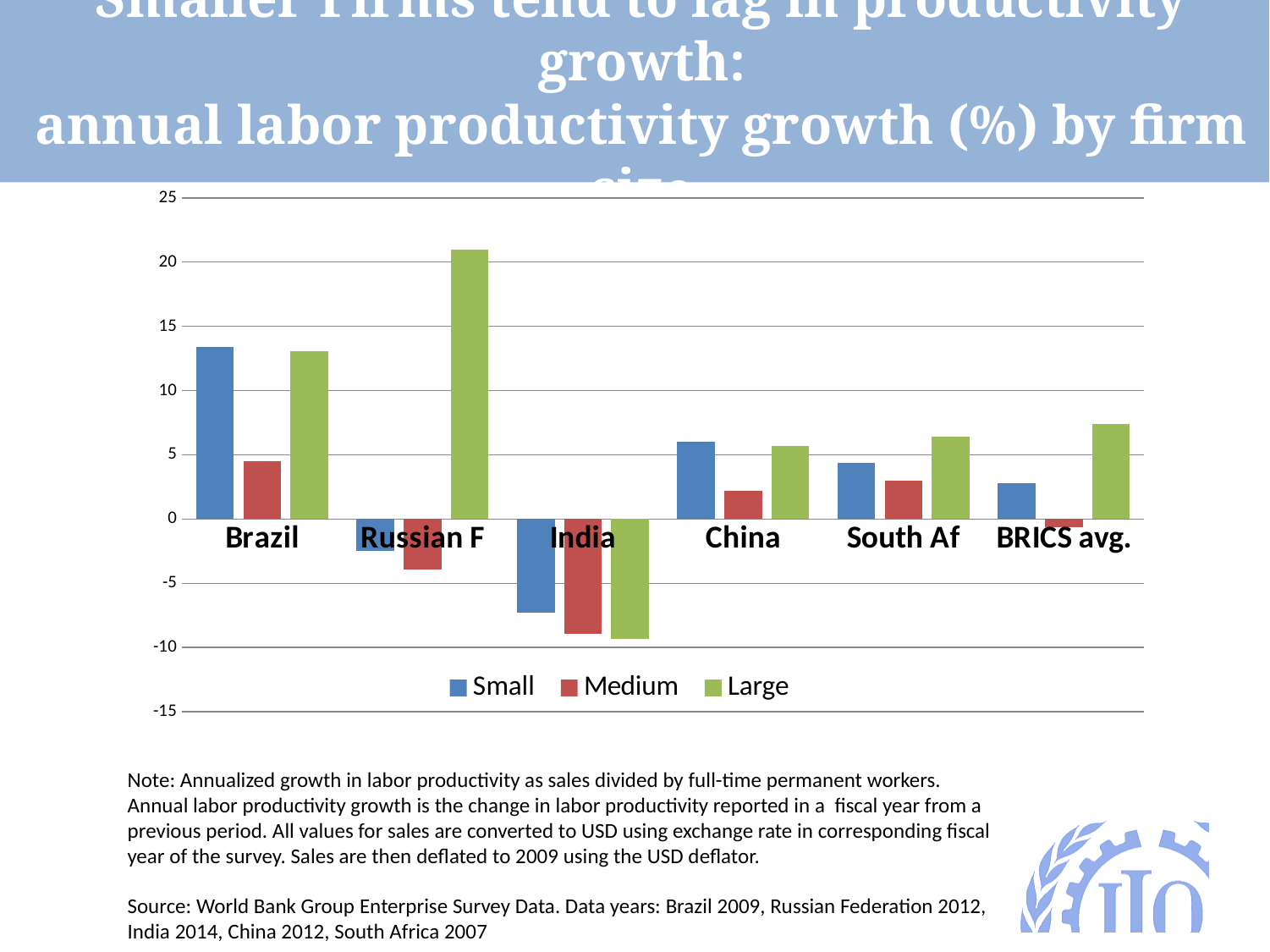
Is the Medium value for India greater or less than -5? less Which series is shown in green in the legend? Large Which category has the highest value for the Small series? Brazil What kind of chart is shown on the slide? bar chart Is the Large value for Russian F greater or less than 20? greater Which category has the lowest value for the Small series? India Which category has the highest value for the Large series? Russian F How many country categories are shown on the x axis? 6 Is the Small value for Brazil greater or less than 10? greater For China, which is larger, the Small value or the Medium value? Small Which category has the lowest value for the Medium series? India How many series does the legend list? 3